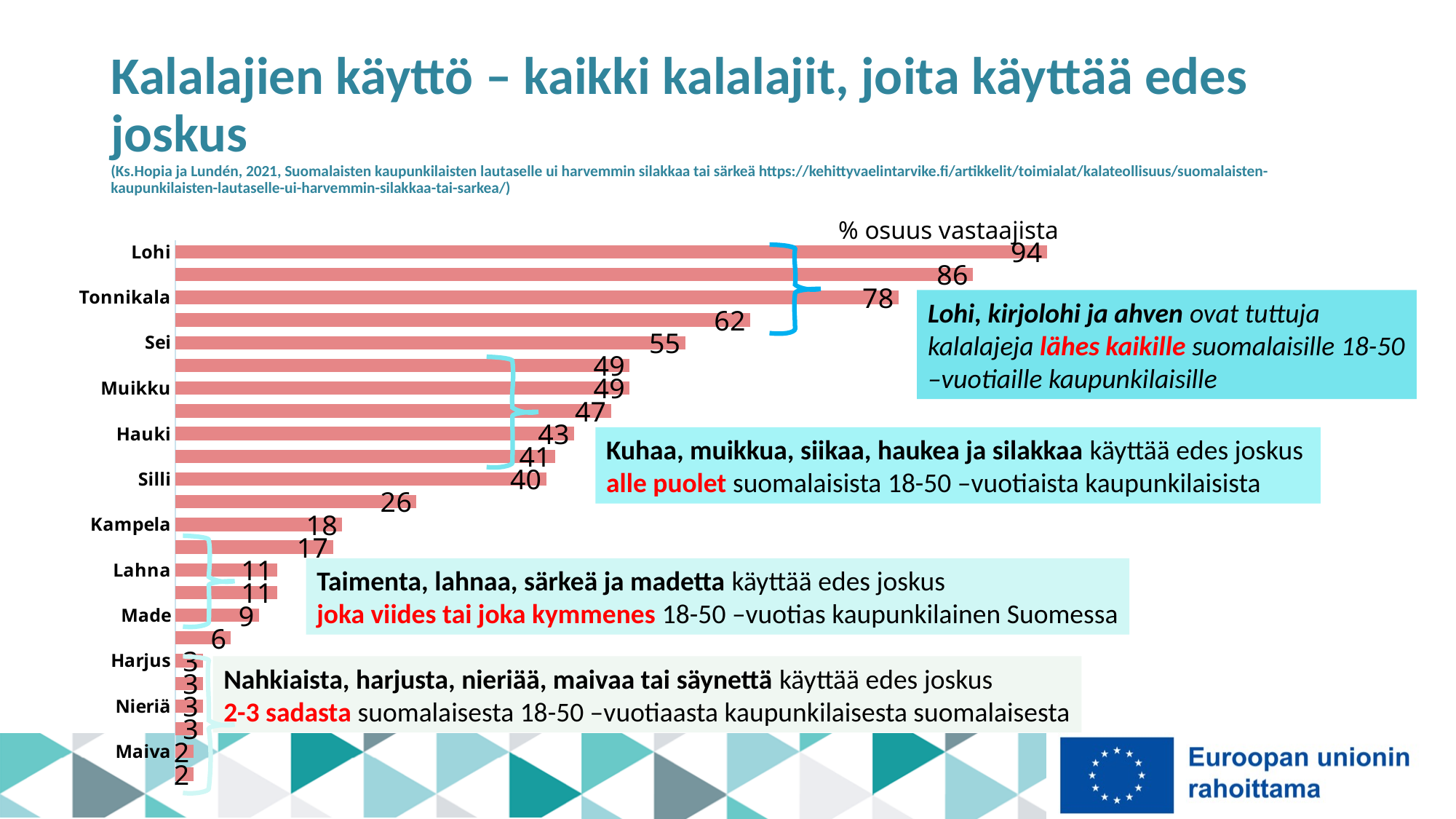
What unit label is shown above the bars in the chart? % osuus vastaajista How many bars are plotted in the chart? 24 Which has a larger value, Hauki or Silli? Hauki What is the value for Tonnikala? 78 What is the value for Hauki? 43 What is the value for Kampela? 18 What kind of chart is shown on the slide? Bar chart What is the value for Made? 9 What is the value for Sei? 55 What is the difference between the values for Lohi and Tonnikala? 16 What is the value for Lohi? 94 Which fish species has the highest value in the chart? Lohi